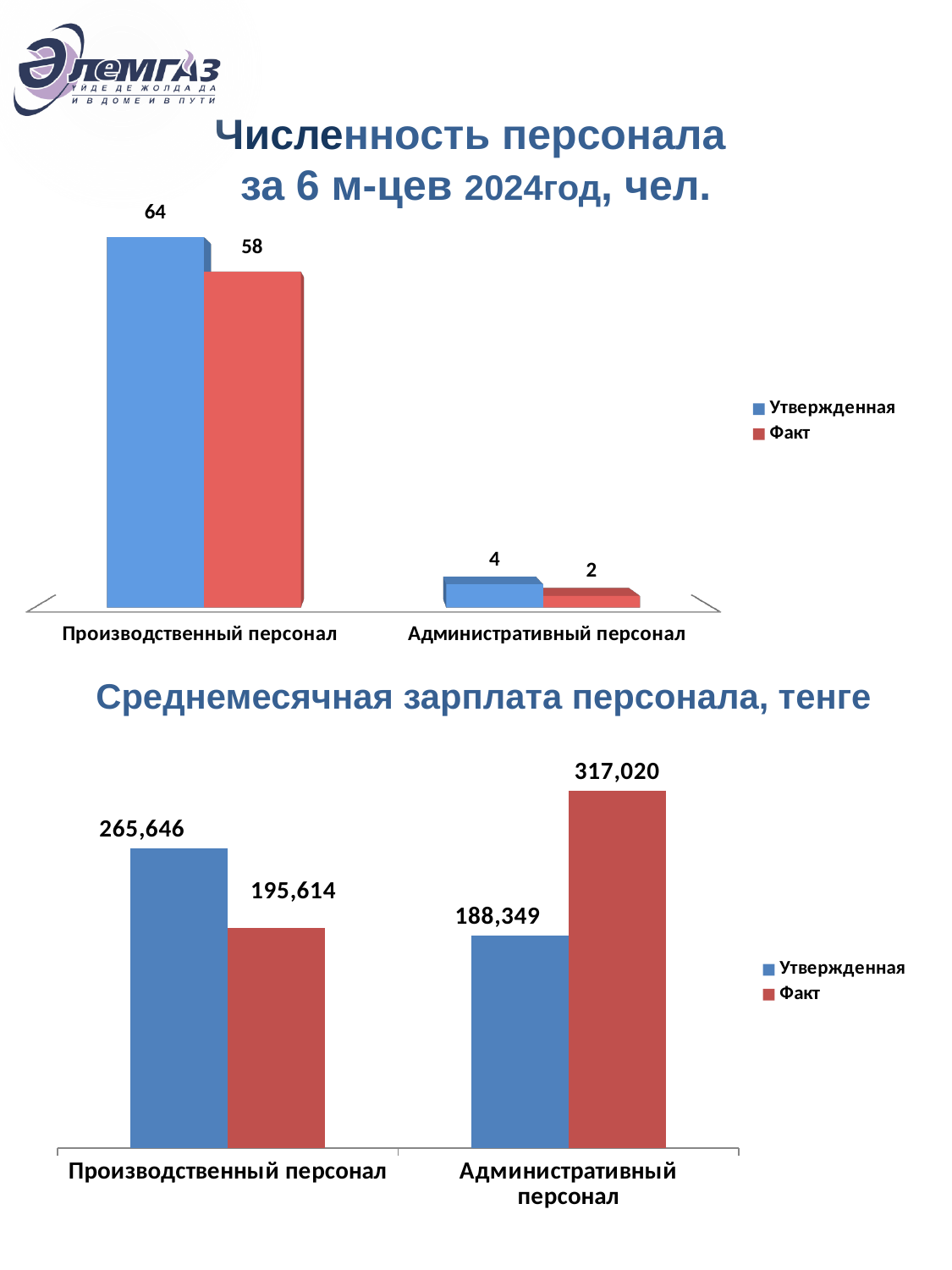
In the bottom chart (Среднемесячная зарплата персонала), what is the Утвержденная value for Производственный персонал? 265,646 In the bottom chart (Среднемесячная зарплата персонала), which category has the highest Факт value? Административный персонал In the top chart (Численность персонала), what kind of chart is shown? Bar chart In the bottom chart (Среднемесячная зарплата персонала), what is the difference between the Факт and Утвержденная values for Административный персонал? 128,671 What is the title of the bottom chart? Среднемесячная зарплата персонала, тенге In the top chart (Численность персонала), what is the Утвержденная value for Производственный персонал? 64 In the bottom chart (Среднемесячная зарплата персонала), what is the Факт value for Административный персонал? 317,020 In the top chart (Численность персонала), how many series does the legend list? 2 In the bottom chart (Среднемесячная зарплата персонала), how many categories are shown on the x axis? 2 In the top chart (Численность персонала), what is the Факт value for Административный персонал? 2 In the top chart (Численность персонала), what is the difference between the Утвержденная and Факт values for Производственный персонал? 6 In the bottom chart (Среднемесячная зарплата персонала), which is larger for Производственный персонал: Утвержденная or Факт? Утвержденная